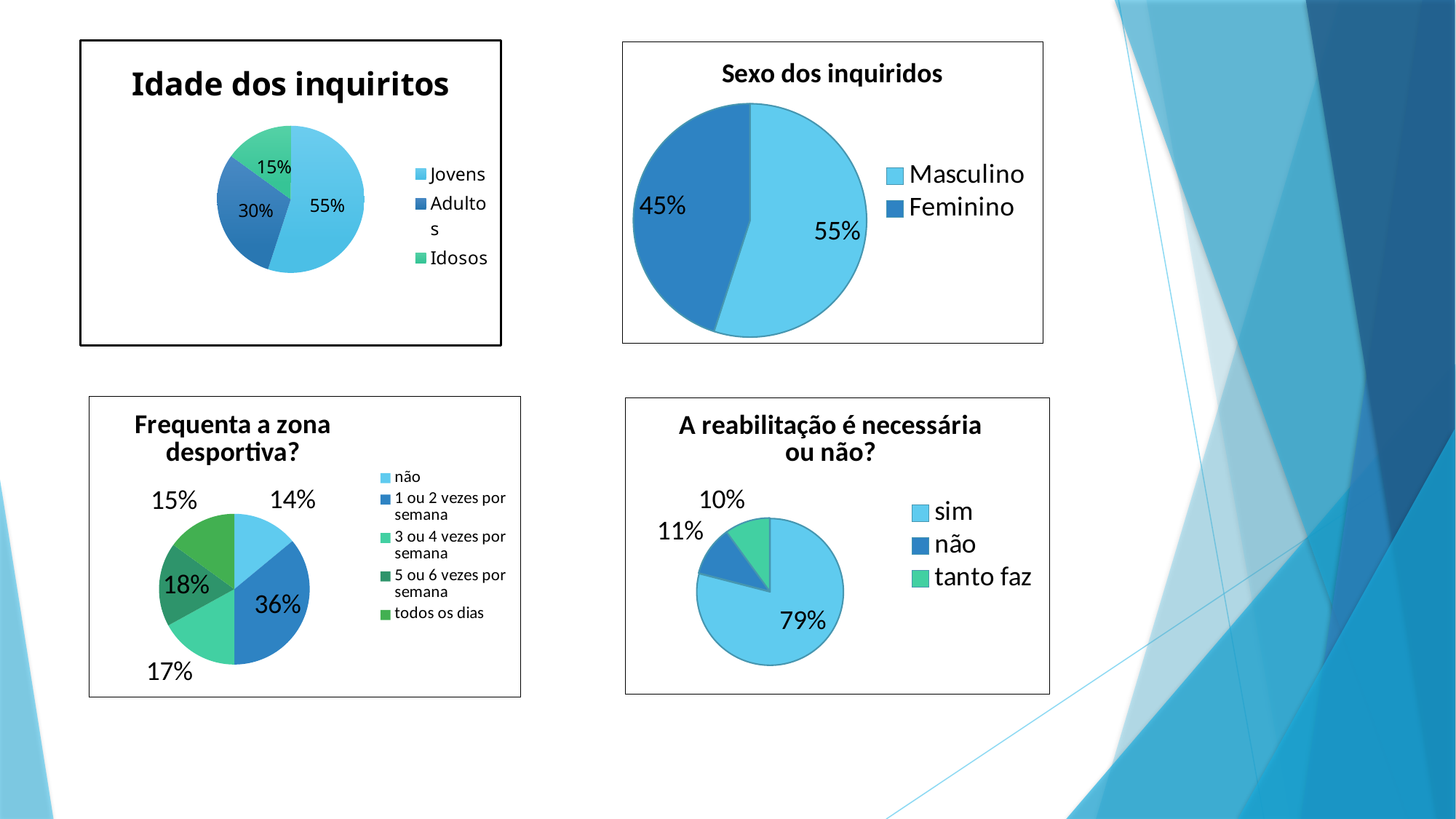
In the 'Frequenta a zona desportiva?' chart, how many categories does the legend list? 5 In the 'Frequenta a zona desportiva?' chart, what share answered '1 ou 2 vezes por semana'? 36% What kind of chart is 'Sexo dos inquiridos'? Pie chart In the 'Sexo dos inquiridos' chart, what percentage is Feminino? 45% In the 'Idade dos inquiritos' chart, what is the difference between the Jovens and Adultos shares? 25% How many pie charts are shown on the slide? 4 In the 'A reabilitação é necessária ou não?' chart, what is the difference between 'não' and 'tanto faz'? 1% In the 'A reabilitação é necessária ou não?' chart, what share answered 'sim'? 79% In the 'Idade dos inquiritos' chart, which category has the smallest slice? Idosos In the 'Sexo dos inquiridos' chart, which is larger, Masculino or Feminino? Masculino In the 'Idade dos inquiritos' chart, what share of respondents are Jovens? 55% In the 'Frequenta a zona desportiva?' chart, which category has the largest slice? 1 ou 2 vezes por semana